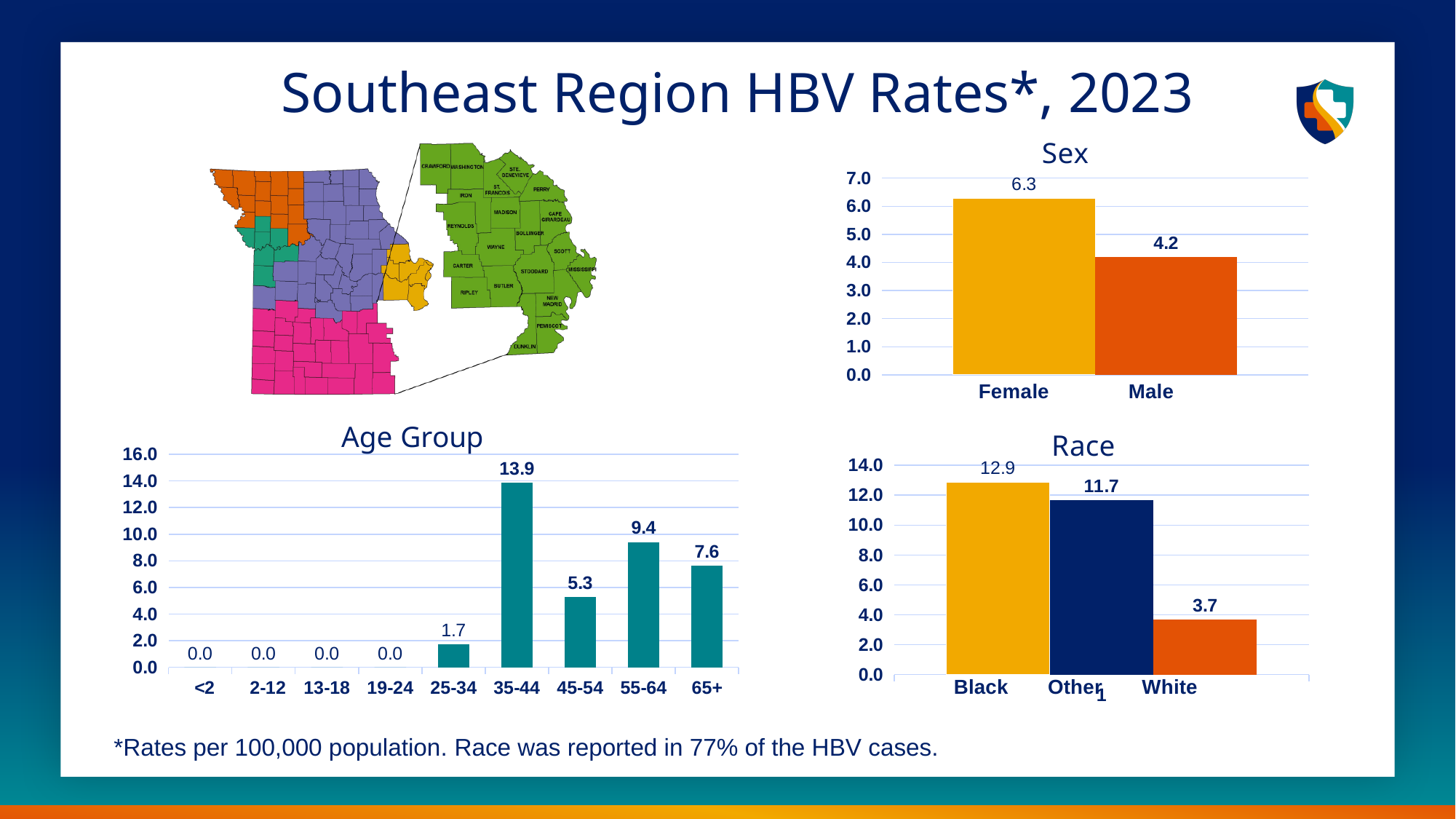
In the Race chart, what is the difference between the Black and White rates? 9.2 In the Sex chart, what is the difference between the Female and Male rates? 2.1 In the Race chart, which race category has the lowest HBV rate? White In the Sex chart, what is the HBV rate for Female? 6.3 In the Sex chart, what is the HBV rate for Male? 4.2 In the Age Group chart, what is the HBV rate for the 55-64 age group? 9.4 What kind of chart is the Race chart? Bar chart In the Age Group chart, which is larger, the rate for 45-54 or the rate for 65+? 65+ In the Race chart, what is the HBV rate for Other? 11.7 In the Age Group chart, how many age group categories are shown on the x axis? 9 In the Age Group chart, which age group has the highest HBV rate? 35-44 In the Age Group chart, what is the HBV rate for the 25-34 age group? 1.7